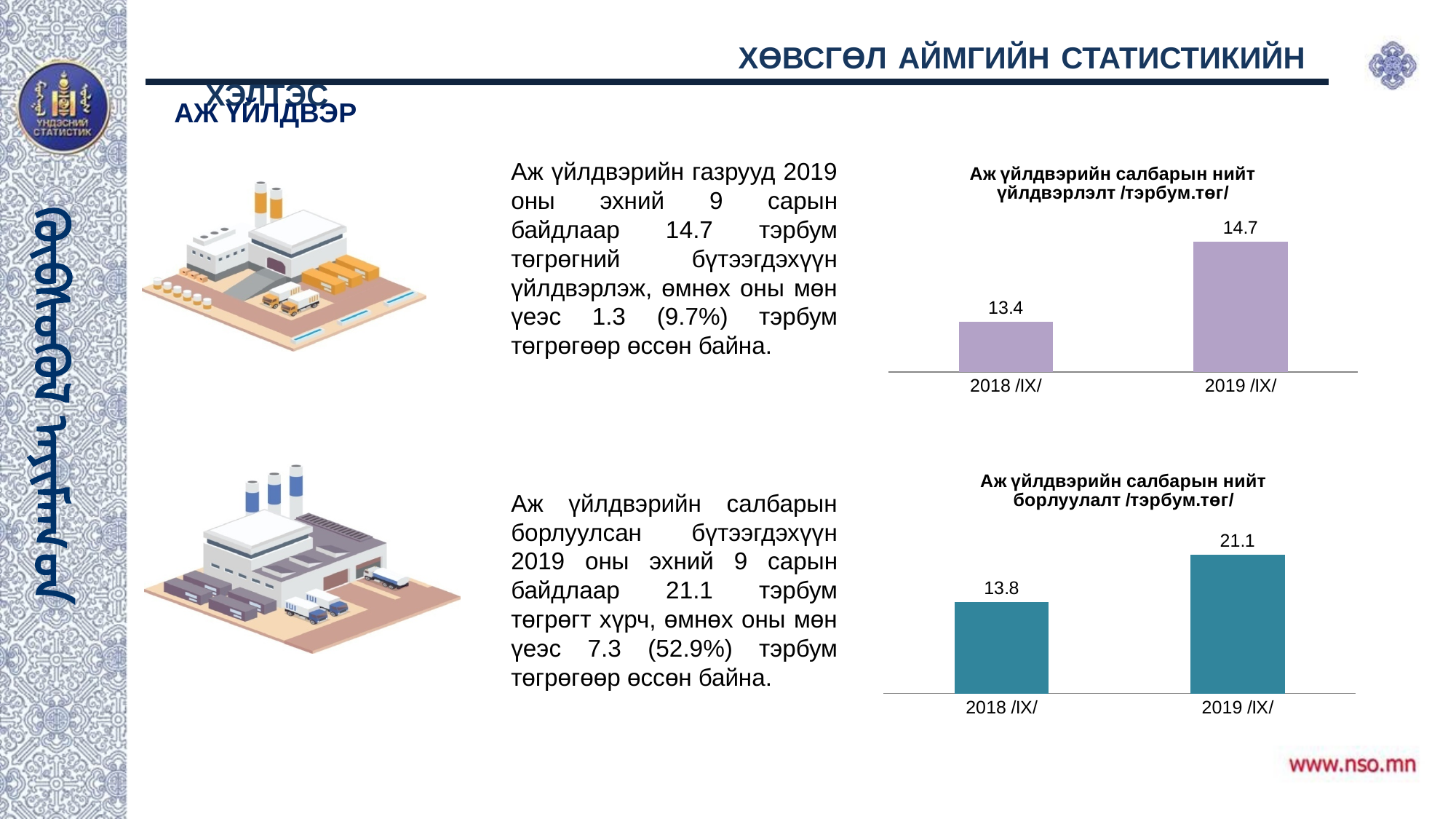
In the top chart, what is the difference between the 2019 /IX/ and 2018 /IX/ values? 1.3 In the top chart (Аж үйлдвэрийн салбарын нийт үйлдвэрлэлт), what is the value for 2019 /IX/? 14.7 In the bottom chart (Аж үйлдвэрийн салбарын нийт борлуулалт), what is the value for 2018 /IX/? 13.8 In the bottom chart, do the values rise or fall from 2018 /IX/ to 2019 /IX/? rise In the top chart, how many categories are plotted? 2 In the bottom chart (Аж үйлдвэрийн салбарын нийт борлуулалт), what is the value for 2019 /IX/? 21.1 In the bottom chart, what is the difference between the 2019 /IX/ and 2018 /IX/ values? 7.3 In the bottom chart, which category has the lowest value? 2018 /IX/ In the top chart (Аж үйлдвэрийн салбарын нийт үйлдвэрлэлт), what is the value for 2018 /IX/? 13.4 What type of chart is the bottom chart? bar chart In the top chart, which category has the highest value? 2019 /IX/ What is the title of the top chart? Аж үйлдвэрийн салбарын нийт үйлдвэрлэлт /тэрбум.төг/